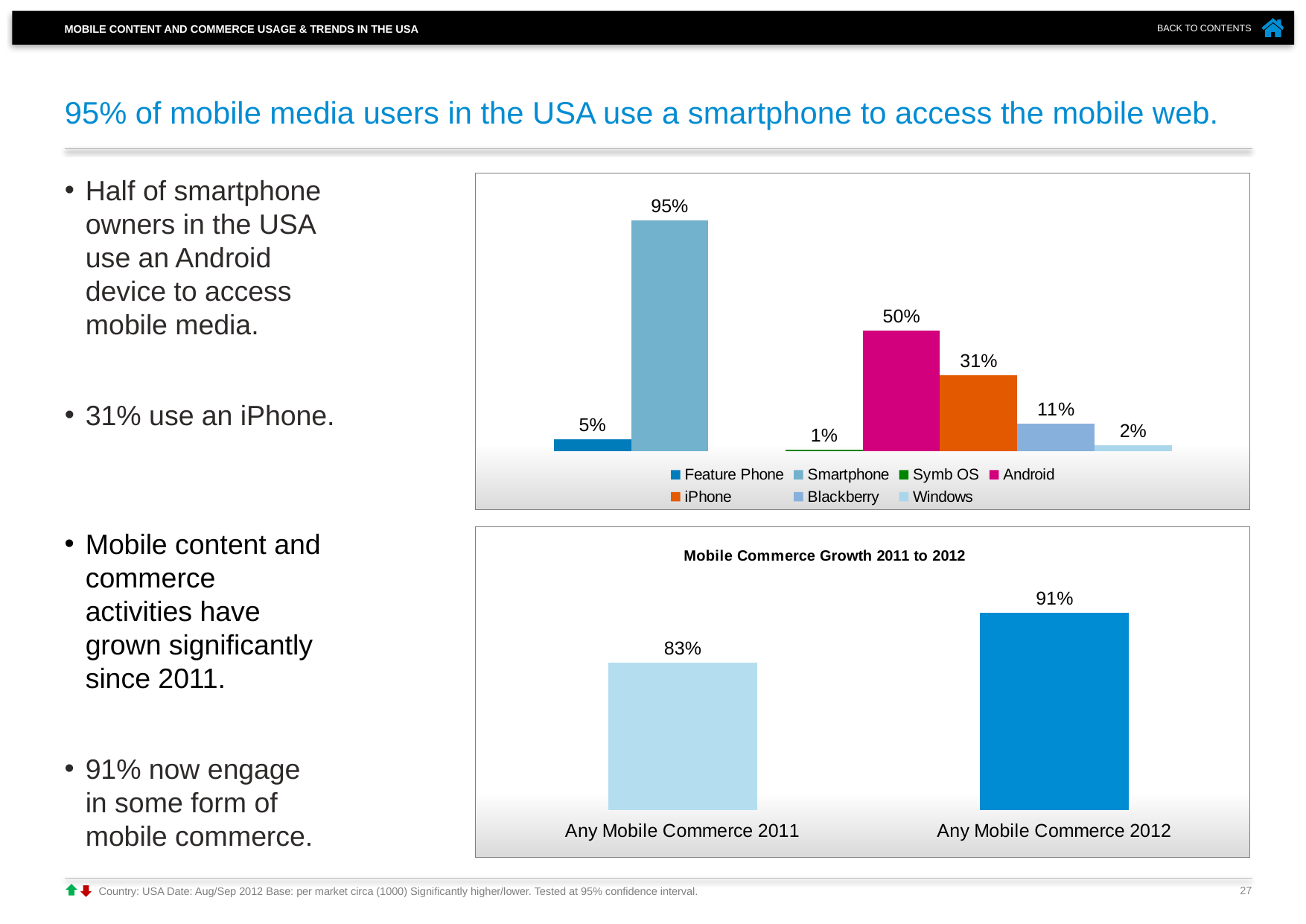
How many series does the legend of the top chart list? 7 In the top chart, what is the value for Android? 50% In the top chart, what is the value for Smartphone? 95% What kind of chart is the chart titled 'Mobile Commerce Growth 2011 to 2012'? bar chart In the chart titled 'Mobile Commerce Growth 2011 to 2012', what is the value for Any Mobile Commerce 2012? 91% In the top chart, what is the difference between the Android and iPhone values? 19% In the chart titled 'Mobile Commerce Growth 2011 to 2012', do the values rise or fall from 2011 to 2012? rise In the top chart, which is larger, Feature Phone or Windows? Feature Phone In the top chart, which series has the highest value? Smartphone In the top chart, which series has the lowest value? Symb OS In the chart titled 'Mobile Commerce Growth 2011 to 2012', what is the difference between the 2012 and 2011 values? 8% In the top chart, what is the value for Blackberry? 11%